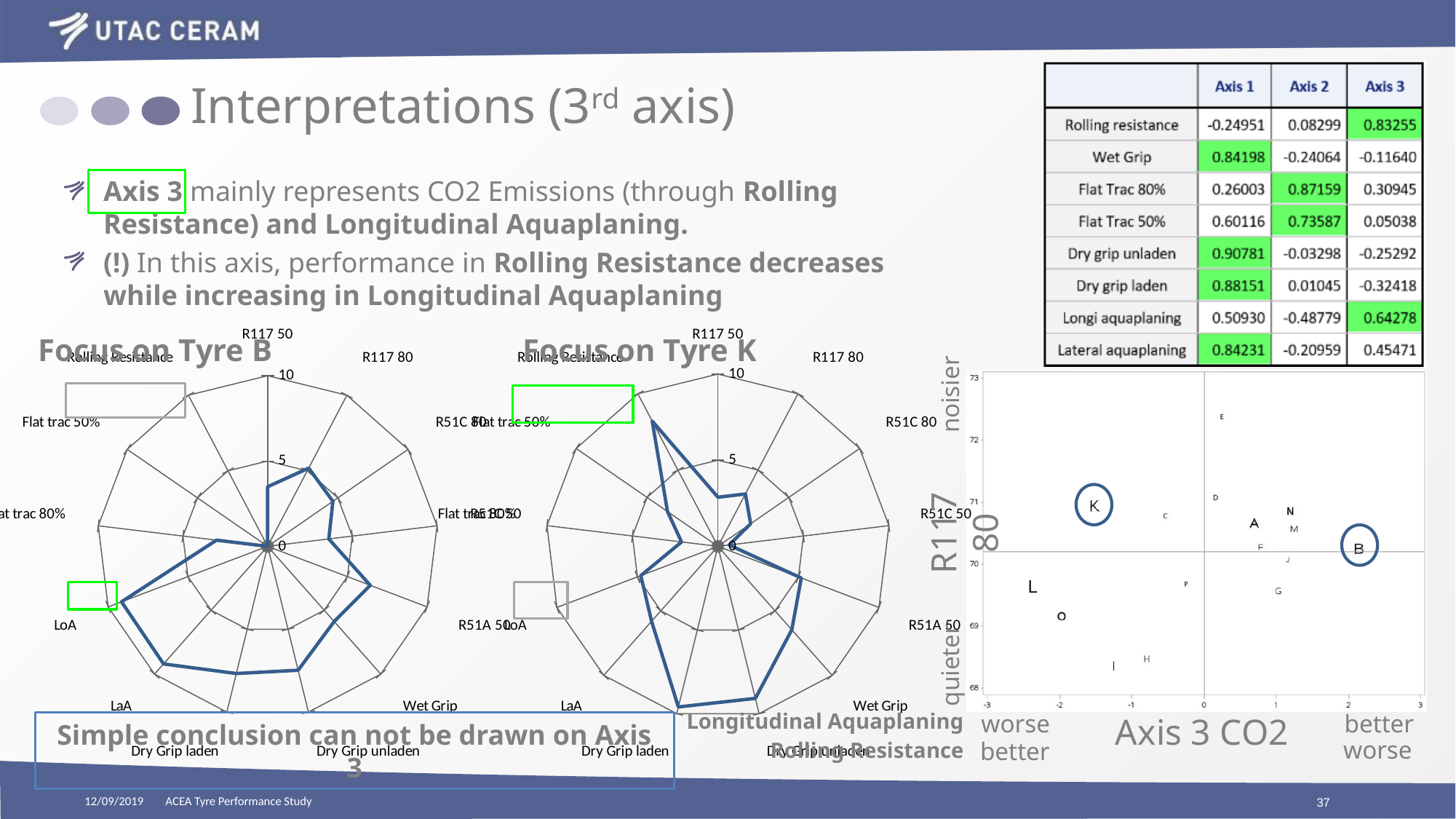
In the 'Focus on Tyre B' chart, how many categories (spokes) are plotted? 13 In the 'Focus on Tyre B' chart, is the value for Flat trac 80% greater or less than 5? less In the scatter chart with the 'Axis 3 CO2' x axis, is the Axis 3 CO2 value for tyre K greater or less than -1? less In the 'Focus on Tyre K' chart, is the value for Rolling Resistance greater or less than 5? greater What kind of chart is the chart in the bottom right with the 'Axis 3 CO2' x axis? scatter chart What kind of chart is the 'Focus on Tyre B' chart? radar chart In the scatter chart in the bottom right, what is the label of the y axis? R117 80 In the scatter chart with the 'Axis 3 CO2' x axis, which tyre has the higher Axis 3 CO2 value, K or B? B